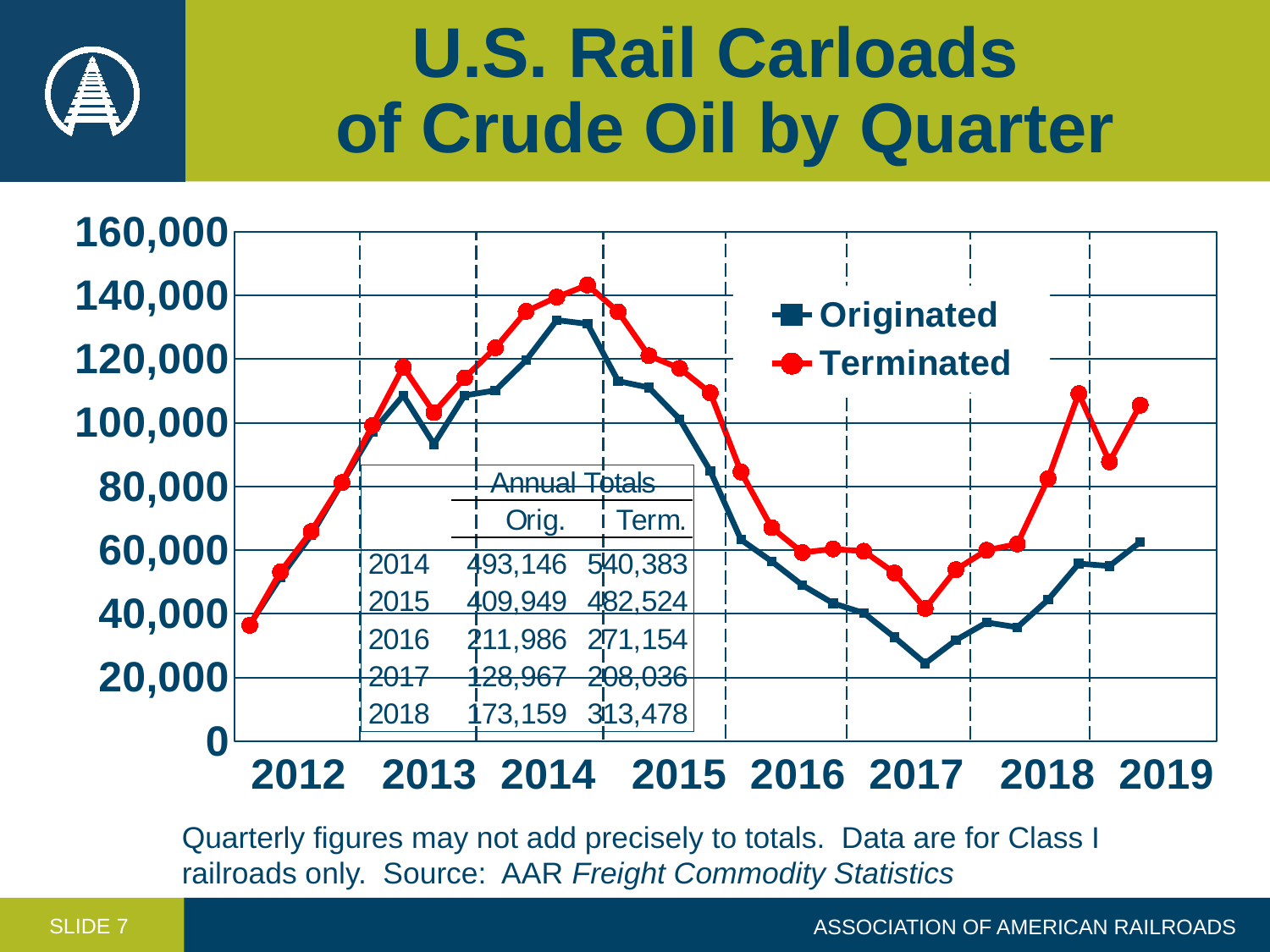
Is the peak value of the Originated series in 2014 greater or less than 120,000? greater How many series does the chart's legend list? 2 In the Annual Totals table, which year has the highest Originated total? 2014 In the Annual Totals table, which year has the lowest Terminated total? 2017 In the Annual Totals table, what is the difference between the Terminated and Originated totals for 2014? 47,237 Is the lowest value of the Originated series in 2017 greater or less than 40,000? less According to the Annual Totals table, what was the Originated total for 2014? 493,146 What are the two series named in the chart legend? Originated and Terminated Do both series rise or fall between their 2014 peaks and 2017? fall According to the Annual Totals table, what was the Terminated total for 2018? 313,478 In 2016, which series has higher quarterly carloads, Originated or Terminated? Terminated What kind of chart is shown on the slide? line chart